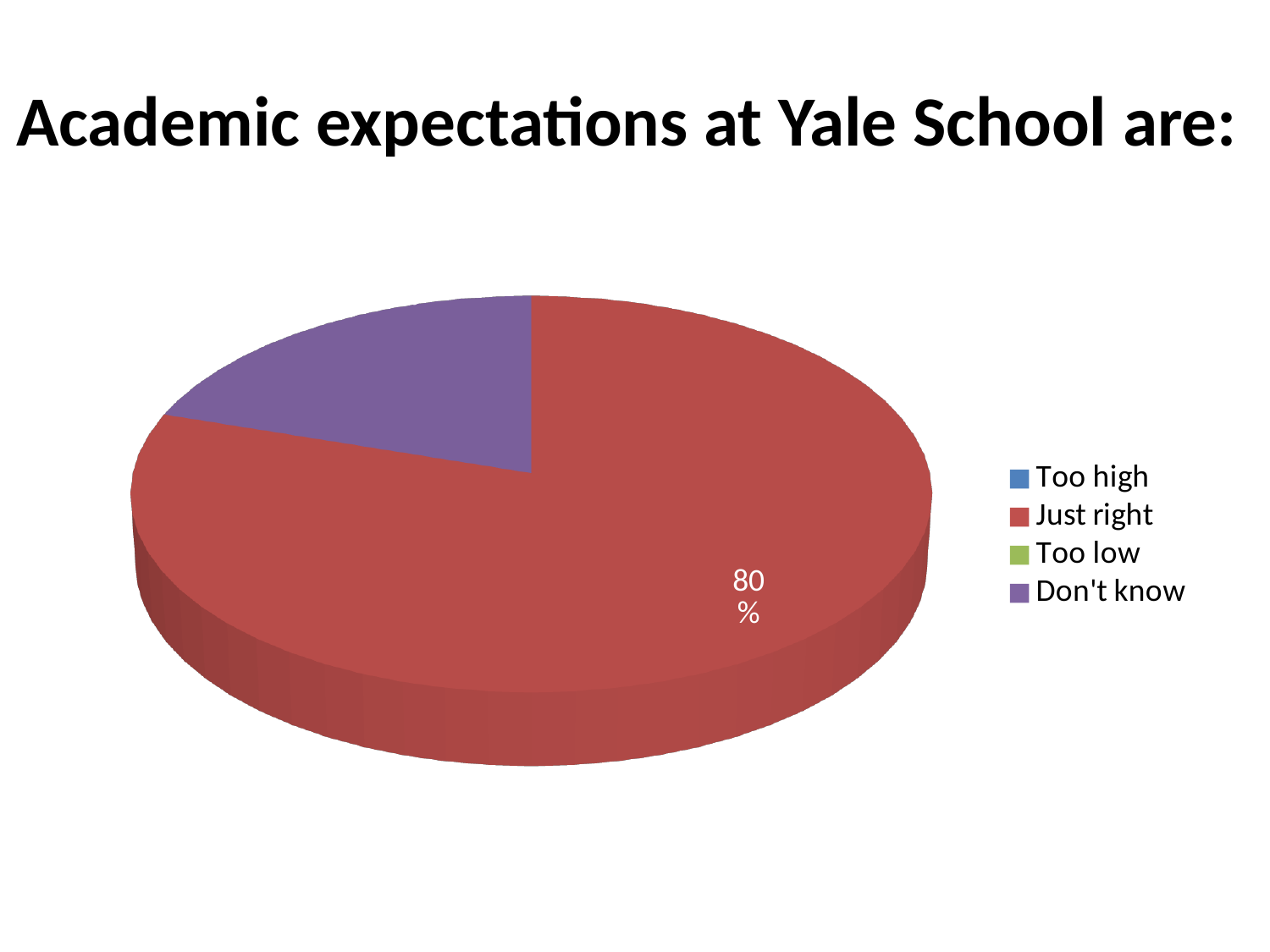
Which category has the largest slice of the pie? Just right How many categories does the legend list? 4 What percentage of the pie is labelled for the 'Just right' slice? 80% What colour is the 'Don't know' slice in the pie chart? purple Which slice of the pie has a data label printed on it? Just right Which slice is larger, 'Just right' or 'Don't know'? Just right What kind of chart is shown on the slide? pie chart What share of the pie does the 'Just right' slice represent? 80% What is the title of the slide? Academic expectations at Yale School are: